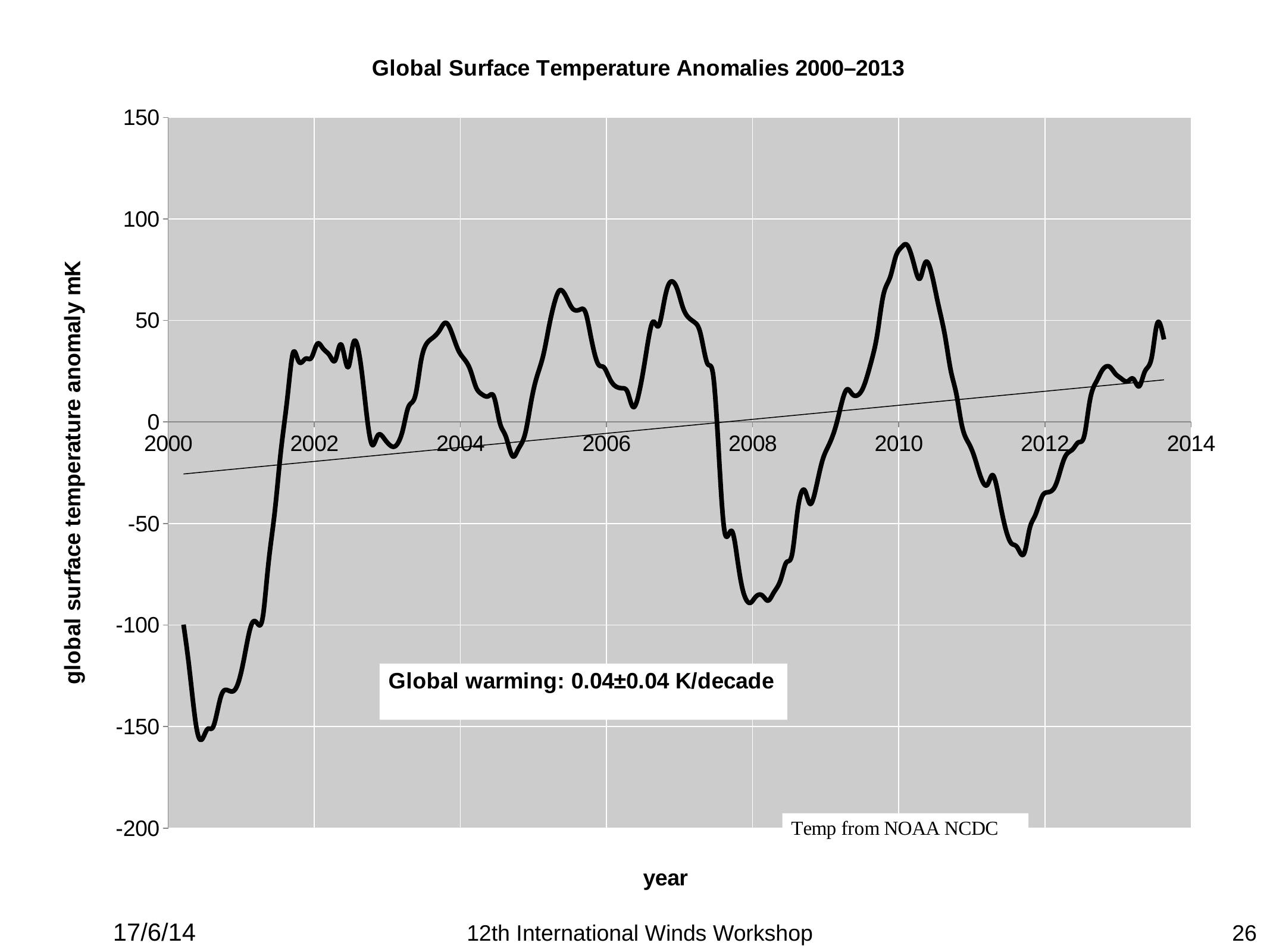
Is the temperature anomaly at the start of 2002 greater or less than 0? greater Is the temperature anomaly at the start of 2012 greater or less than 0? less Is the temperature anomaly at the start of 2004 greater or less than 0? greater In which year does the temperature anomaly reach its lowest value? 2000 Which is larger, the temperature anomaly peak around 2010 or the peak around 2004? the peak around 2010 Does the thin straight trend line rise or fall from 2000 to 2014? rise What is the title of the chart? Global Surface Temperature Anomalies 2000–2013 What global warming rate is stated in the text box on the chart? 0.04±0.04 K/decade What kind of chart is shown on the slide? line chart